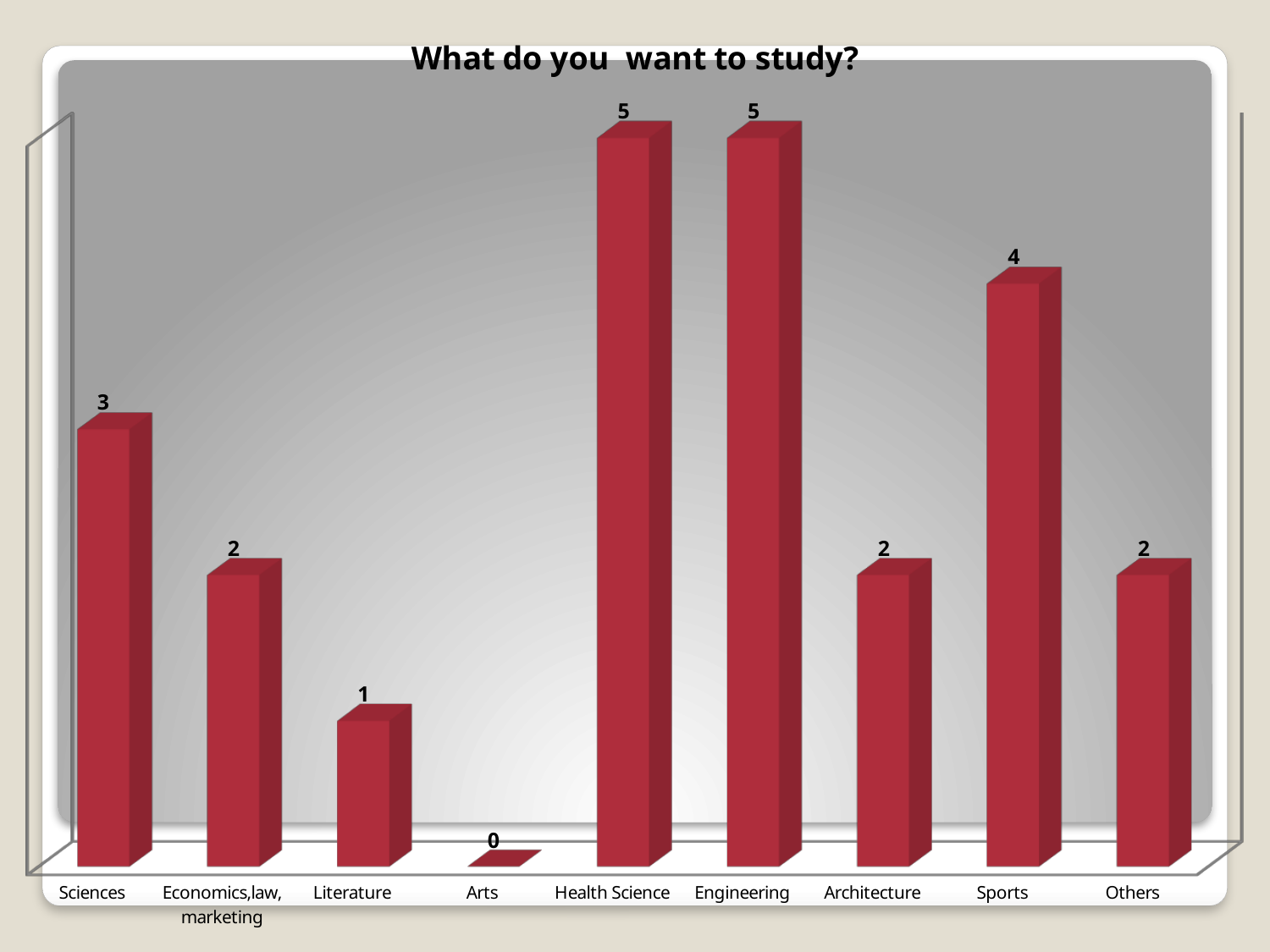
What is the difference between the values for Health Science and Sciences? 2 What kind of chart is this? Bar chart What is the value for Literature? 1 What is the value for Health Science? 5 Which category has the lowest value? Arts What is the difference between the values for Engineering and Others? 3 How many categories are shown on the x axis? 9 What is the value for Sports? 4 What is the value for Arts? 0 Which is larger, the value for Sports or the value for Architecture? Sports What is the value for Sciences? 3 What is the title of the chart? What do you want to study?